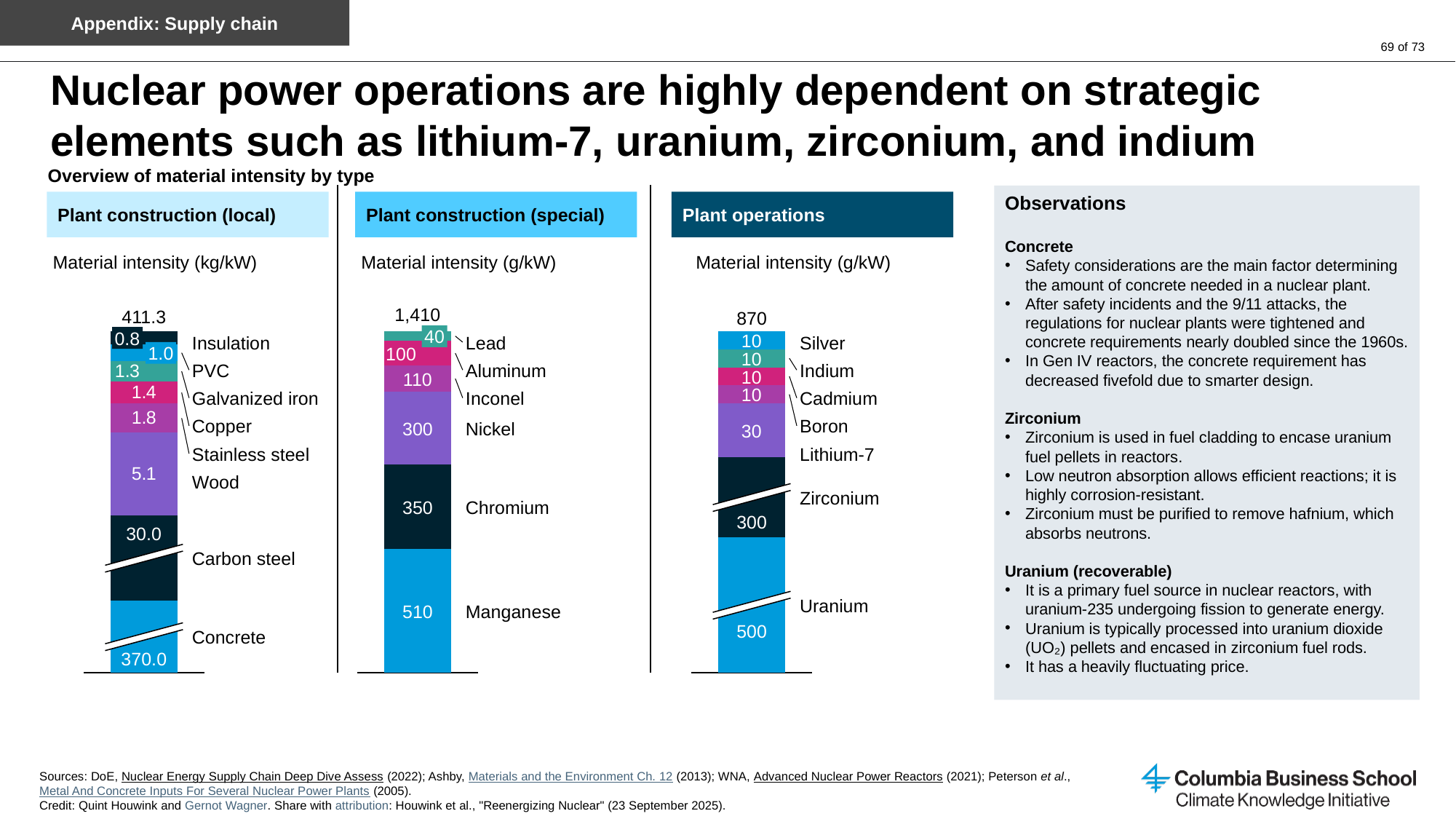
In the Plant operations chart, what is the material intensity of Uranium? 500 In the Plant construction (local) chart, what is the total material intensity shown at the top of the stacked bar? 411.3 In the Plant construction (special) chart, what is the difference between the Chromium and Nickel values? 50 In the Plant operations chart, what is the total material intensity shown at the top of the stacked bar? 870 In the Plant operations chart, which material has the highest material intensity? Uranium In the Plant construction (local) chart, what is the material intensity of Concrete? 370.0 What type of chart is used in the Plant operations panel? Stacked bar chart In the Plant construction (special) chart, which material has the lowest material intensity? Lead In the Plant construction (special) chart, how many materials are stacked in the bar? 6 In the Plant construction (special) chart, what is the material intensity of Manganese? 510 In the Plant operations chart, what is the difference between the Uranium and Zirconium values? 200 In the Plant construction (local) chart, what is the material intensity of Carbon steel? 30.0